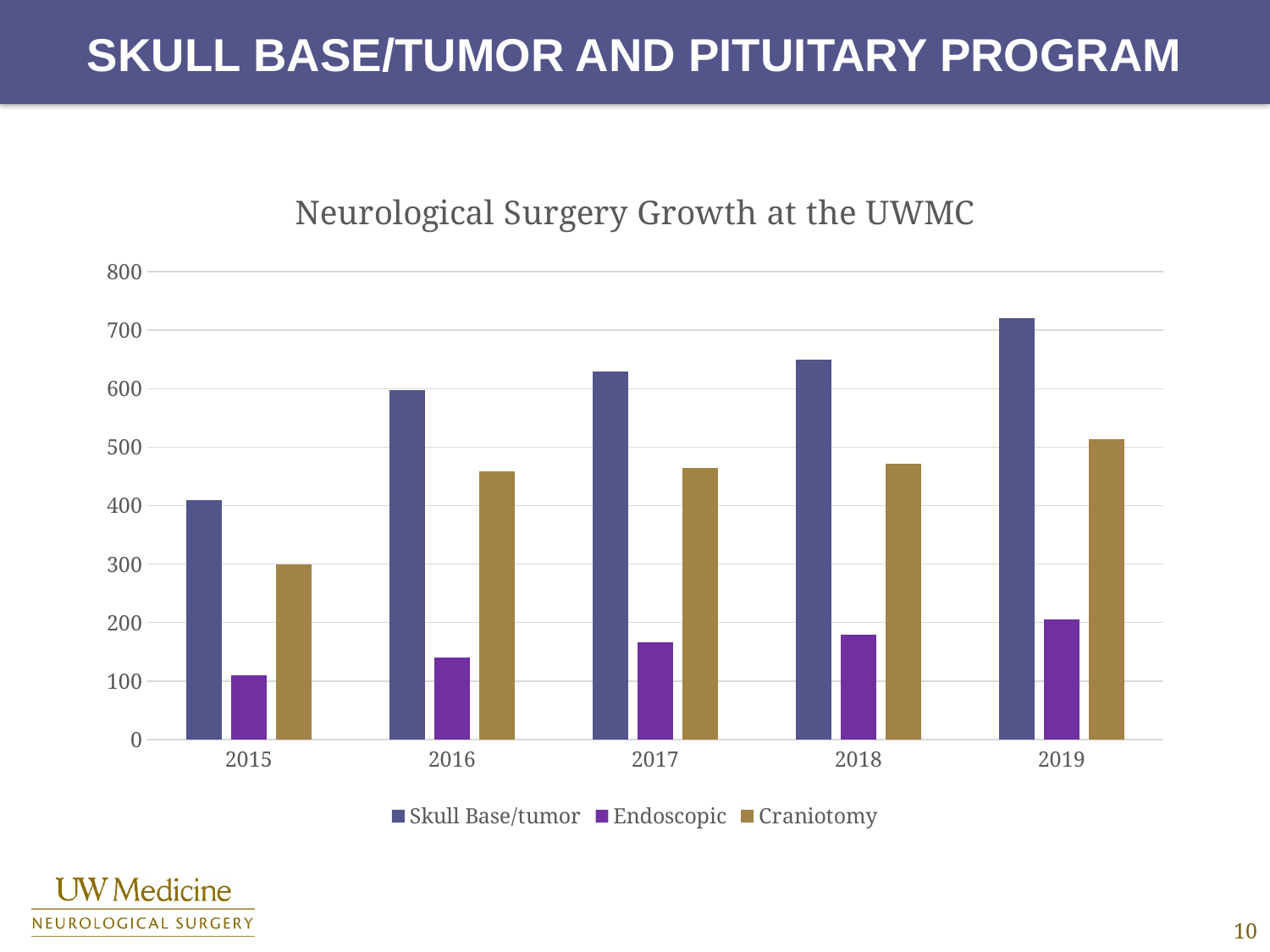
Is the Craniotomy value for 2015 greater or less than 400? less In which year is the Endoscopic value lowest? 2015 How many years are shown on the x axis? 5 Is the Endoscopic value for 2018 greater or less than 200? less Which series has the highest value in 2018? Skull Base/tumor In which year is the Skull Base/tumor value highest? 2019 Is the Skull Base/tumor value for 2019 greater or less than 700? greater Do the Skull Base/tumor values rise or fall from 2015 to 2019? rise How many series does the legend list? 3 What is the title of the chart? Neurological Surgery Growth at the UWMC What kind of chart is shown on the slide? bar chart In 2017, which is larger: Craniotomy or Endoscopic? Craniotomy